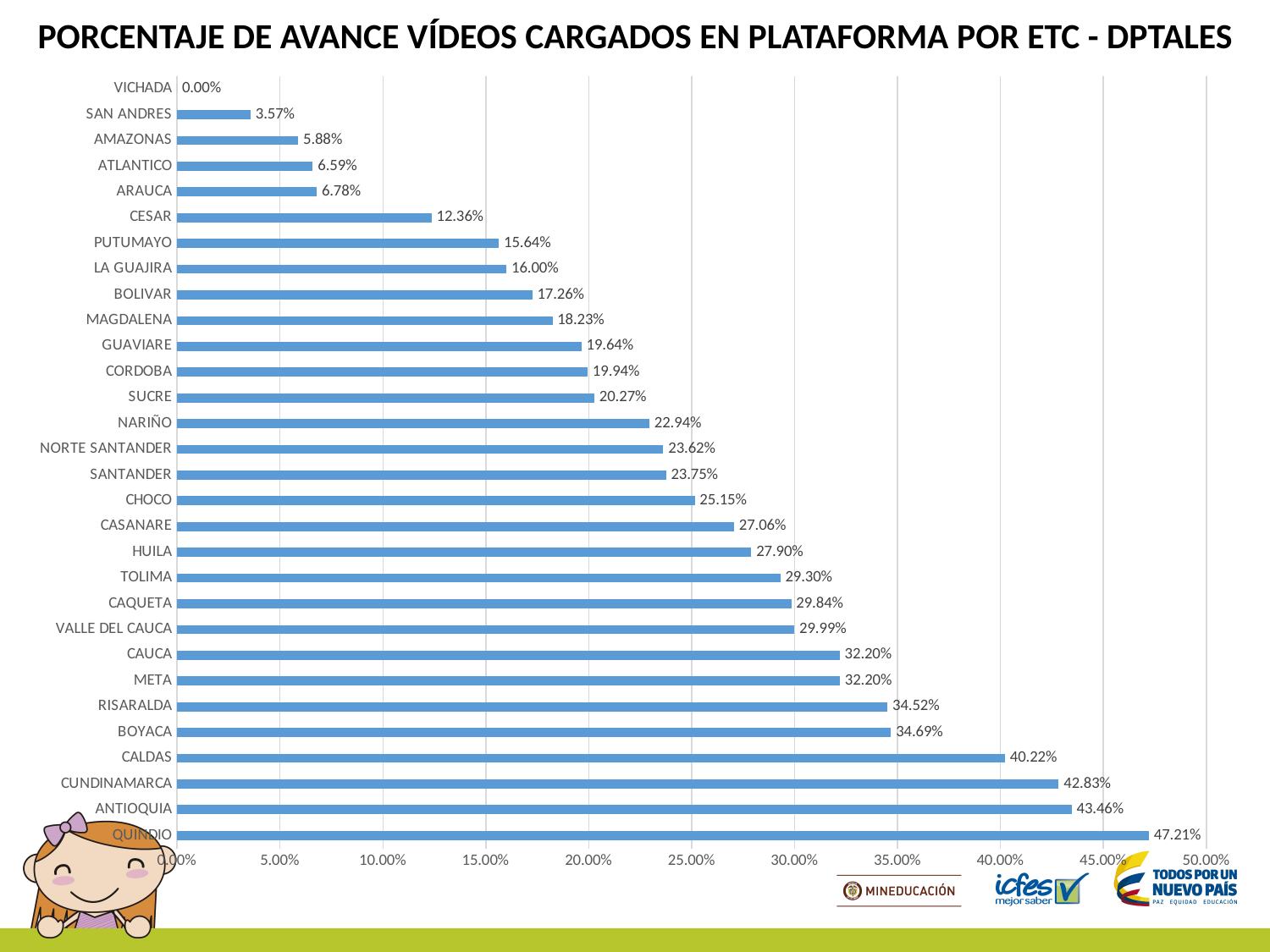
Which is larger, the value for CHOCO or the value for SUCRE? CHOCO What kind of chart is shown on the slide? bar chart How many categories are shown in the chart? 30 What is the value for NORTE SANTANDER? 23.62% Which category has the lowest value? VICHADA What is the value for CUNDINAMARCA? 42.83% What is the difference between the values for CESAR and ARAUCA? 5.58% What is the difference between the values for CUNDINAMARCA and CALDAS? 2.61% Is the value for HUILA greater or less than 25.00%? greater What is the title of the chart? PORCENTAJE DE AVANCE VÍDEOS CARGADOS EN PLATAFORMA POR ETC - DPTALES What is the value for LA GUAJIRA? 16.00% Which category has the highest value? QUINDIO